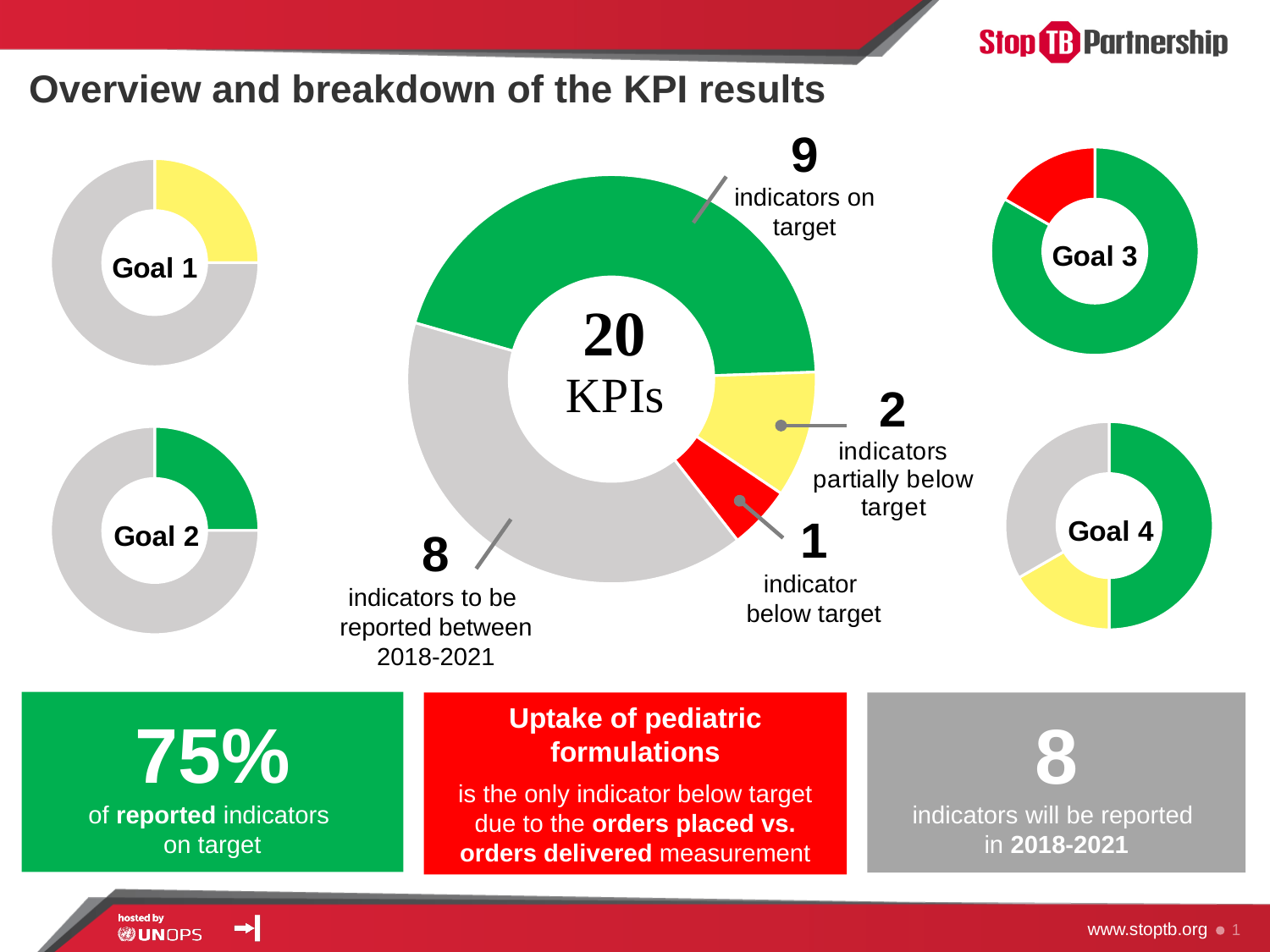
What is the total number of KPIs shown in the central donut chart? 20 In the central donut chart, what is the difference between the number of indicators on target and the number partially below target? 7 In the central donut chart, how many indicators are to be reported between 2018-2021? 8 In the central donut chart, how many indicators are partially below target? 2 In the central donut chart, how many indicators are below target? 1 In the central donut chart, how many indicators are on target? 9 In the central donut chart, which category has the smallest number of indicators? indicator below target What kind of chart is the central chart labelled 20 KPIs? donut (pie) chart In the central donut chart, which category has the largest number of indicators? indicators on target In the central donut chart, what colour is the segment for indicators on target? green How many segments does the central donut chart have? 4 In the central donut chart, which is larger: the number of indicators on target or the number to be reported between 2018-2021? indicators on target